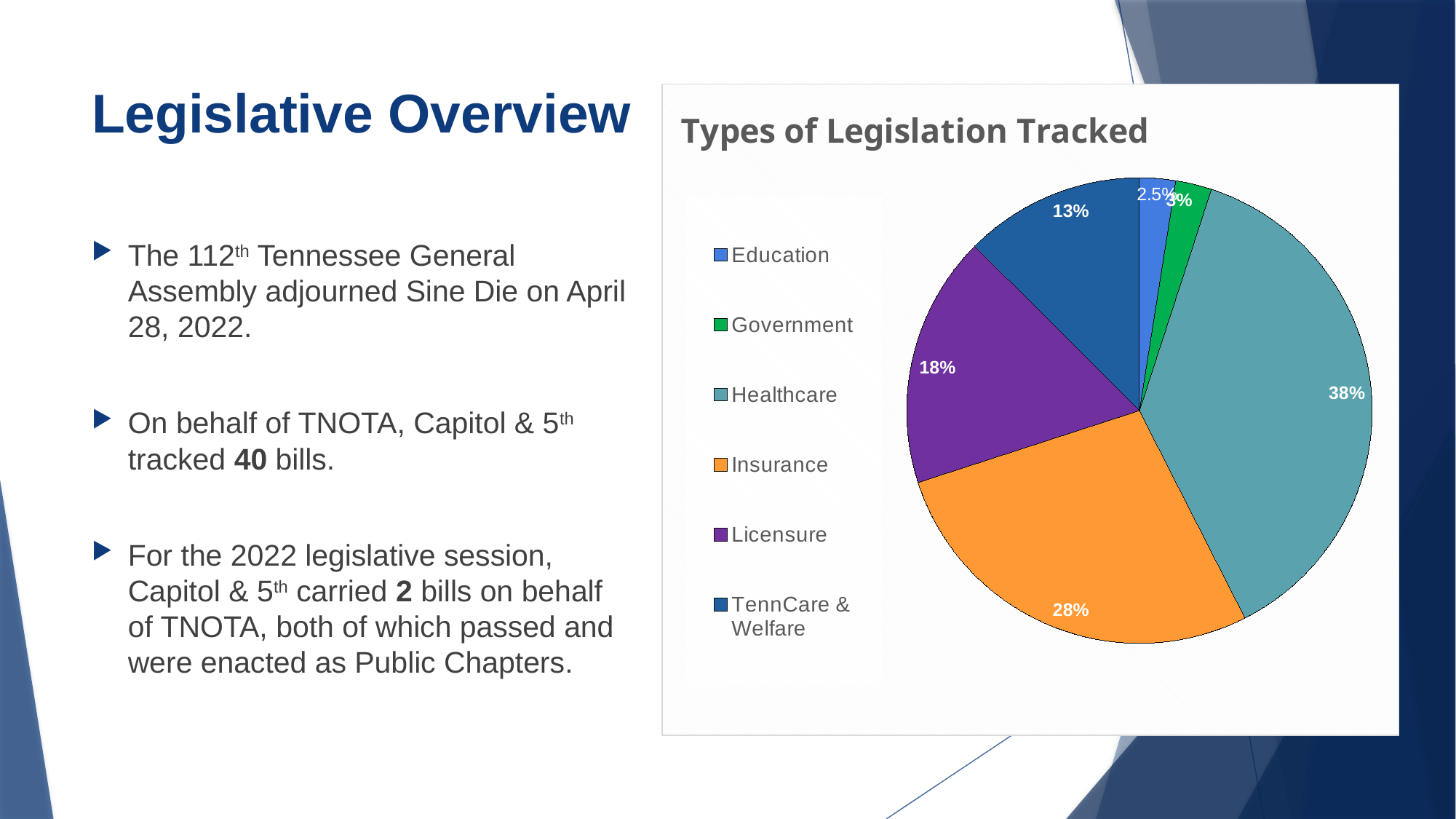
What percentage is shown for TennCare & Welfare? 13% What is the difference between the Healthcare and Insurance percentages? 10% What kind of chart is shown on the slide? Pie chart What share of the pie does Healthcare represent? 38% What percentage is shown for Insurance? 28% Which category has the largest slice of the pie? Healthcare How many categories does the legend list? 6 Which is larger, the Licensure slice or the TennCare & Welfare slice? Licensure What is the title of the chart? Types of Legislation Tracked What percentage is shown for Education? 2.5% What percentage is shown for Licensure? 18%